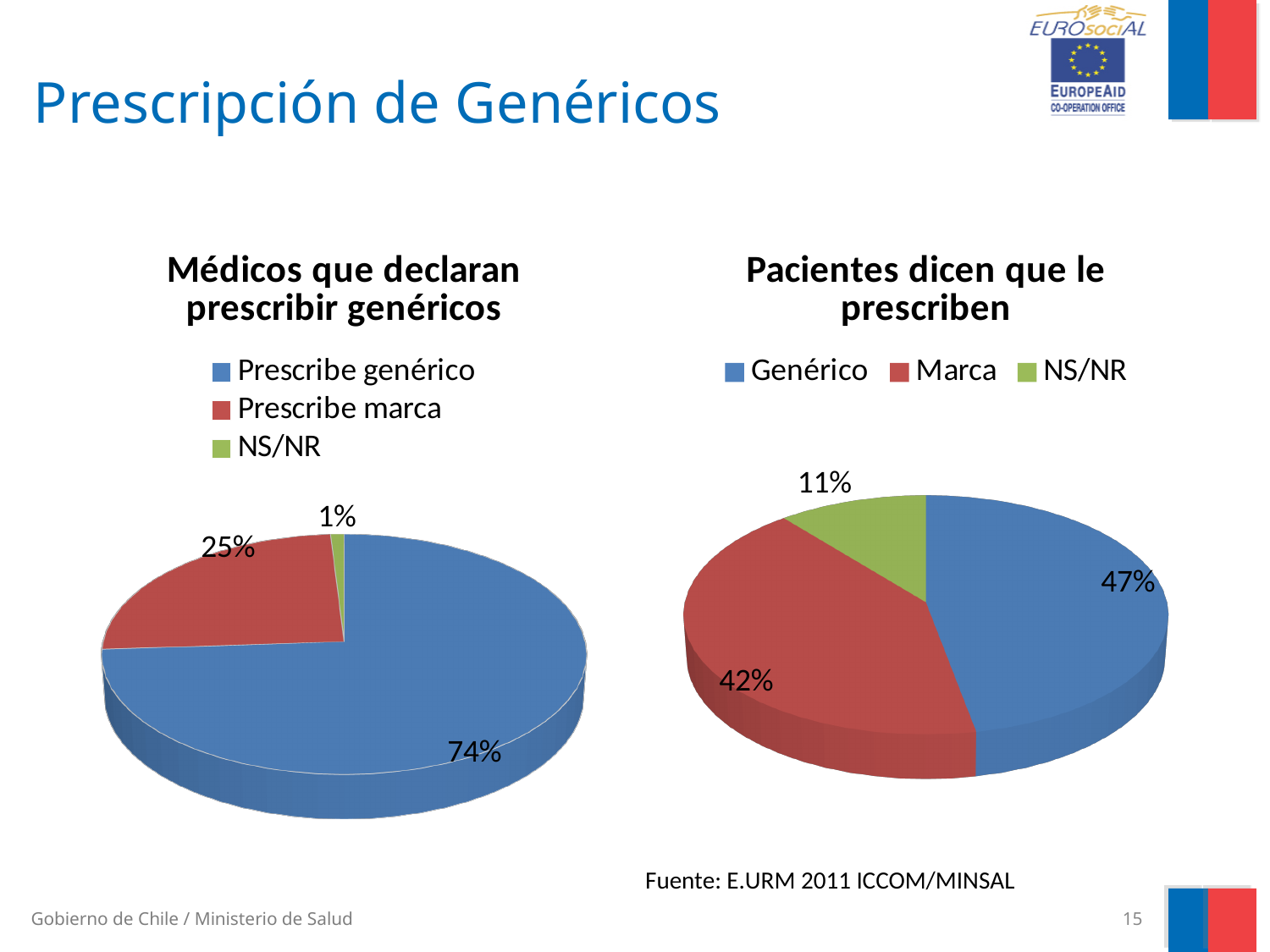
In the chart titled 'Médicos que declaran prescribir genéricos', which category has the largest share? Prescribe genérico How many entries does the legend of the chart titled 'Médicos que declaran prescribir genéricos' list? 3 In the chart titled 'Médicos que declaran prescribir genéricos', what is the difference in percentage points between 'Prescribe genérico' and 'Prescribe marca'? 49 In the chart titled 'Pacientes dicen que le prescriben', what percentage is shown for 'NS/NR'? 11% What type of chart is the chart titled 'Pacientes dicen que le prescriben'? Pie chart In the chart titled 'Pacientes dicen que le prescriben', what percentage is shown for 'Marca'? 42% In the chart titled 'Pacientes dicen que le prescriben', which is larger, 'Genérico' or 'Marca'? Genérico In the chart titled 'Médicos que declaran prescribir genéricos', what percentage is shown for 'NS/NR'? 1% In the chart titled 'Pacientes dicen que le prescriben', which category has the smallest share? NS/NR In the chart titled 'Médicos que declaran prescribir genéricos', what percentage is shown for 'Prescribe marca'? 25% In the chart titled 'Médicos que declaran prescribir genéricos', what percentage is shown for 'Prescribe genérico'? 74% In the chart titled 'Pacientes dicen que le prescriben', what percentage is shown for 'Genérico'? 47%